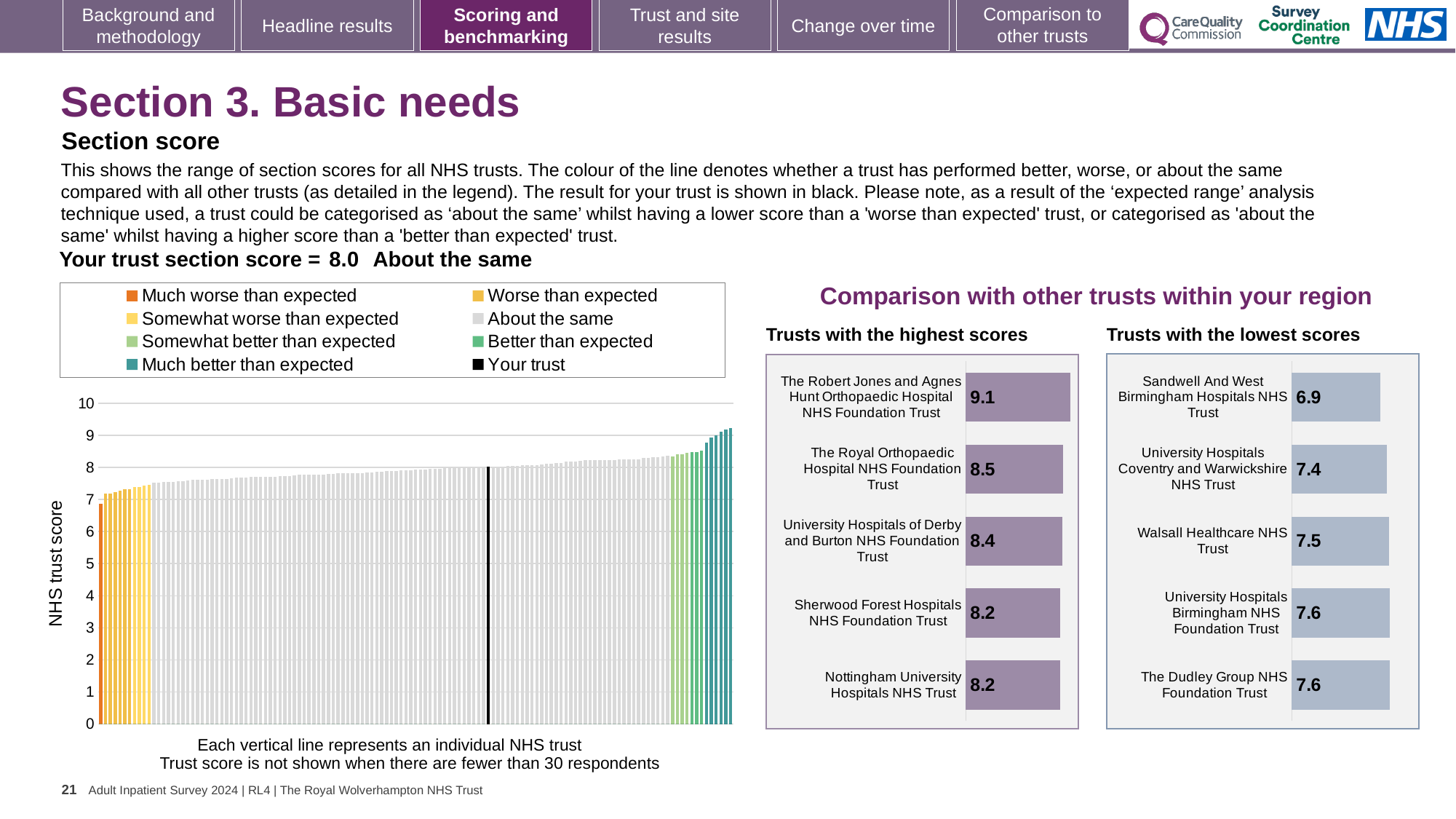
In the 'Trusts with the lowest scores' chart, what is the score for Sandwell And West Birmingham Hospitals NHS Trust? 6.9 In the 'Trusts with the highest scores' chart, what is the difference between the scores of The Robert Jones and Agnes Hunt Orthopaedic Hospital NHS Foundation Trust and The Royal Orthopaedic Hospital NHS Foundation Trust? 0.6 In the 'Trusts with the lowest scores' chart, what is the difference between the scores of Walsall Healthcare NHS Trust and Sandwell And West Birmingham Hospitals NHS Trust? 0.6 In the 'Trusts with the lowest scores' chart, what is the score for University Hospitals Coventry and Warwickshire NHS Trust? 7.4 In the 'Trusts with the highest scores' chart, which has the higher score: University Hospitals of Derby and Burton NHS Foundation Trust or Sherwood Forest Hospitals NHS Foundation Trust? University Hospitals of Derby and Burton NHS Foundation Trust How many trusts are shown in the 'Trusts with the highest scores' chart? 5 What kind of chart is the large chart on the left showing NHS trust scores? Bar chart In the 'Trusts with the highest scores' chart, what is the score for The Robert Jones and Agnes Hunt Orthopaedic Hospital NHS Foundation Trust? 9.1 In the 'Trusts with the highest scores' chart, which trust has the highest score? The Robert Jones and Agnes Hunt Orthopaedic Hospital NHS Foundation Trust In the 'Trusts with the lowest scores' chart, which trust has the lowest score? Sandwell And West Birmingham Hospitals NHS Trust What is the label on the vertical axis of the large chart on the left? NHS trust score How many entries does the legend of the large chart on the left list? 8